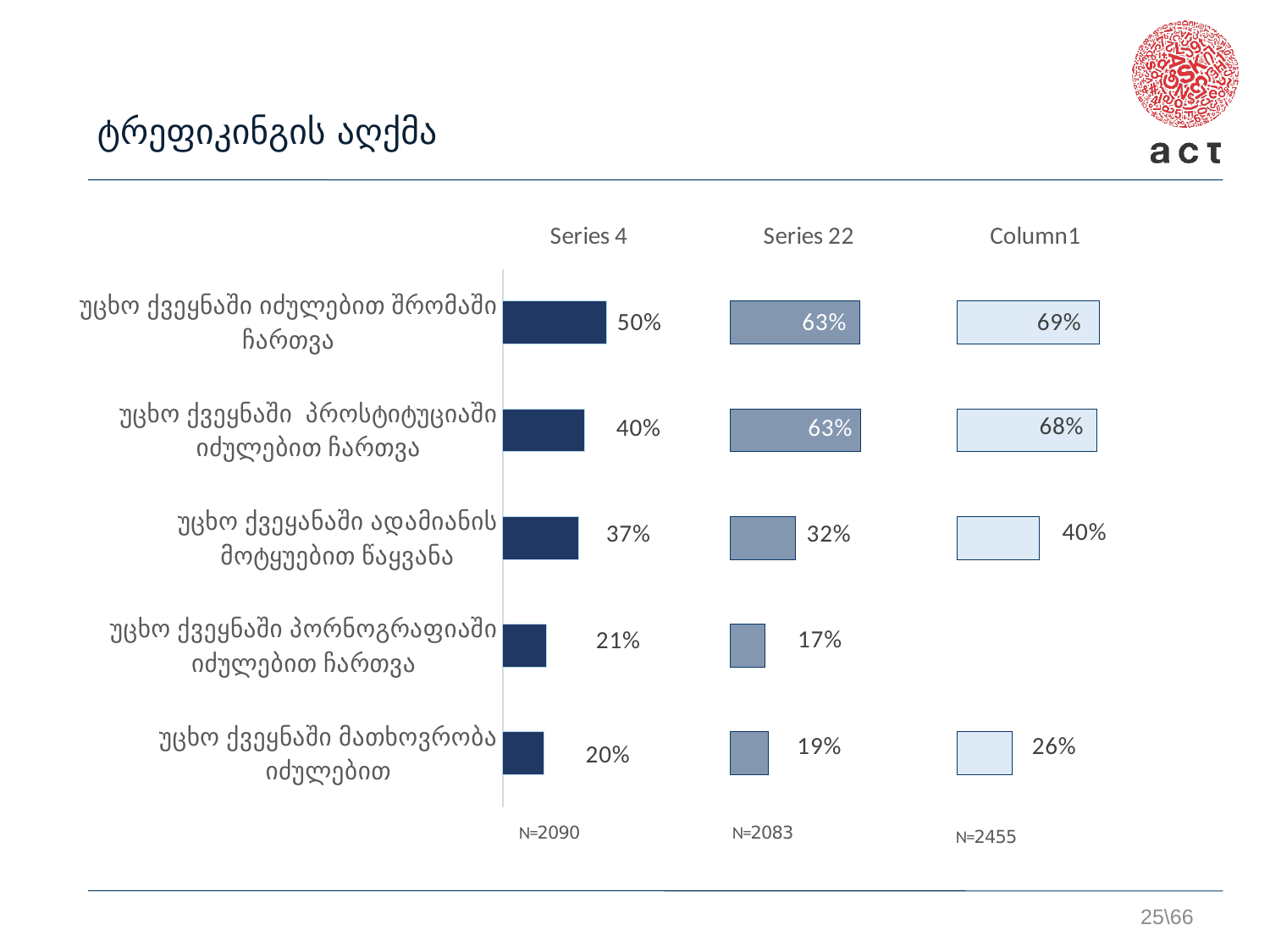
In the Series 4 chart, what is the difference between the values for უცხო ქვეყნაში იძულებით შრომაში ჩართვა and უცხო ქვეყნაში პროსტიტუციაში იძულებით ჩართვა? 10% In the Series 22 chart, what is the value for უცხო ქვეყნაში პორნოგრაფიაში იძულებით ჩართვა? 17% In the Column1 chart, what is the value for უცხო ქვეყნაში პროსტიტუციაში იძულებით ჩართვა? 68% How many categories are shown in the Series 4 chart? 5 In the Series 4 chart, which category has the highest value? უცხო ქვეყნაში იძულებით შრომაში ჩართვა In the Series 22 chart, which category has the lowest value? უცხო ქვეყნაში პორნოგრაფიაში იძულებით ჩართვა What is the sample size (N) shown under the Column1 chart? N=2455 What kind of chart is used on this slide? Bar chart What is the title of the slide? ტრეფიკინგის აღქმა In the Column1 chart, what is the value for უცხო ქვეყნაში მათხოვრობა იძულებით? 26% In the Series 4 chart, what is the value for უცხო ქვეყნაში იძულებით შრომაში ჩართვა? 50% For უცხო ქვეყანაში ადამიანის მოტყუებით წაყვანა, which chart shows the larger value, Series 4 or Series 22? Series 4